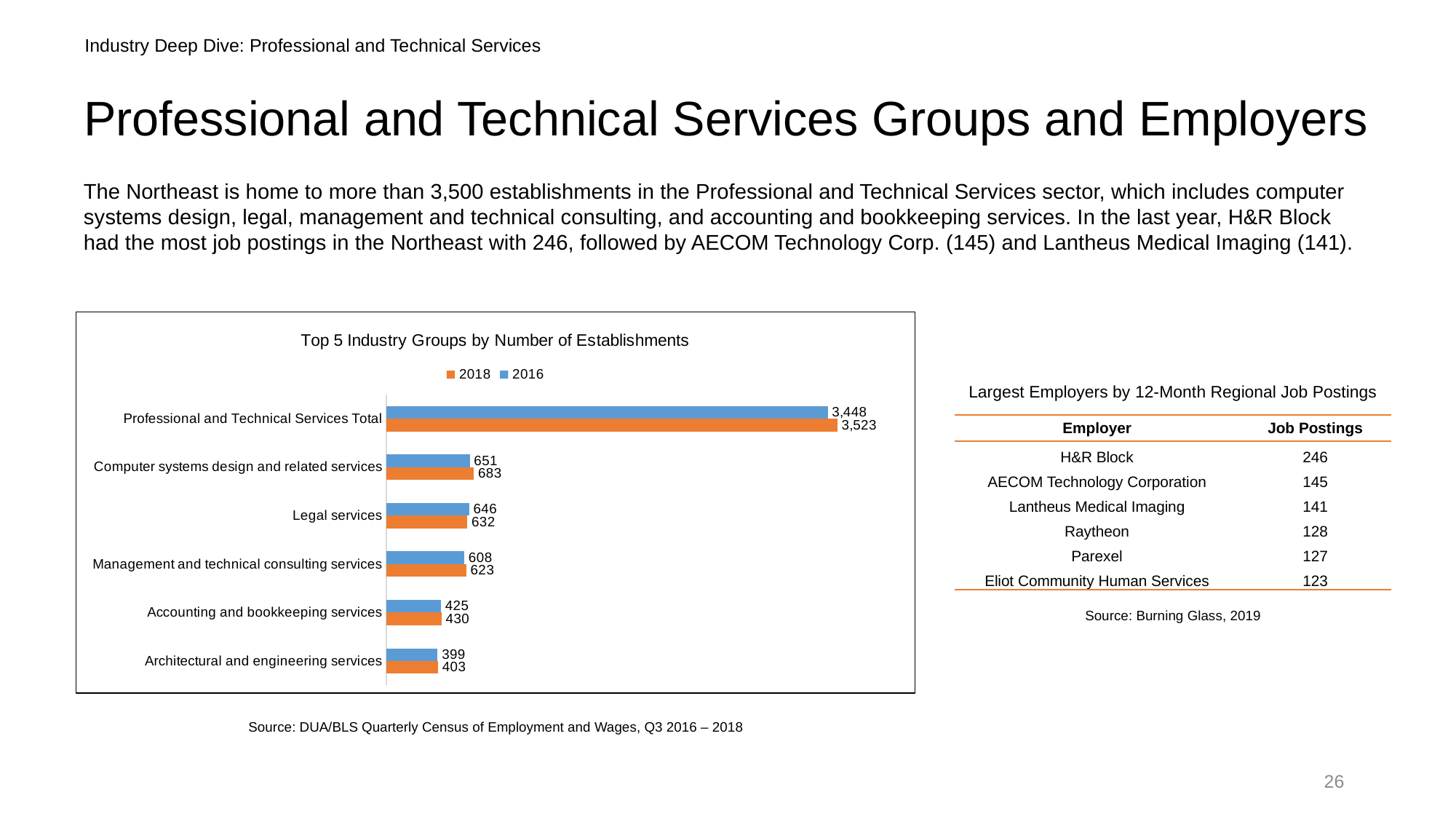
Which colour represents the 2016 series in the 'Top 5 Industry Groups by Number of Establishments' chart? blue How many categories are shown on the 'Top 5 Industry Groups by Number of Establishments' chart? 6 Excluding the total, which industry group has the highest number of establishments in 2018? Computer systems design and related services What is the 2016 value for Accounting and bookkeeping services? 425 What is the 2016 value for Computer systems design and related services? 651 What is the difference between the 2018 and 2016 values for Computer systems design and related services? 32 How many series does the legend of the 'Top 5 Industry Groups by Number of Establishments' chart list? 2 Excluding the total, which industry group has the lowest number of establishments in 2018? Architectural and engineering services What is the 2018 value for Professional and Technical Services Total? 3,523 What type of chart is 'Top 5 Industry Groups by Number of Establishments'? bar chart What is the difference between the 2018 and 2016 values for Professional and Technical Services Total? 75 What is the 2018 value for Legal services? 632